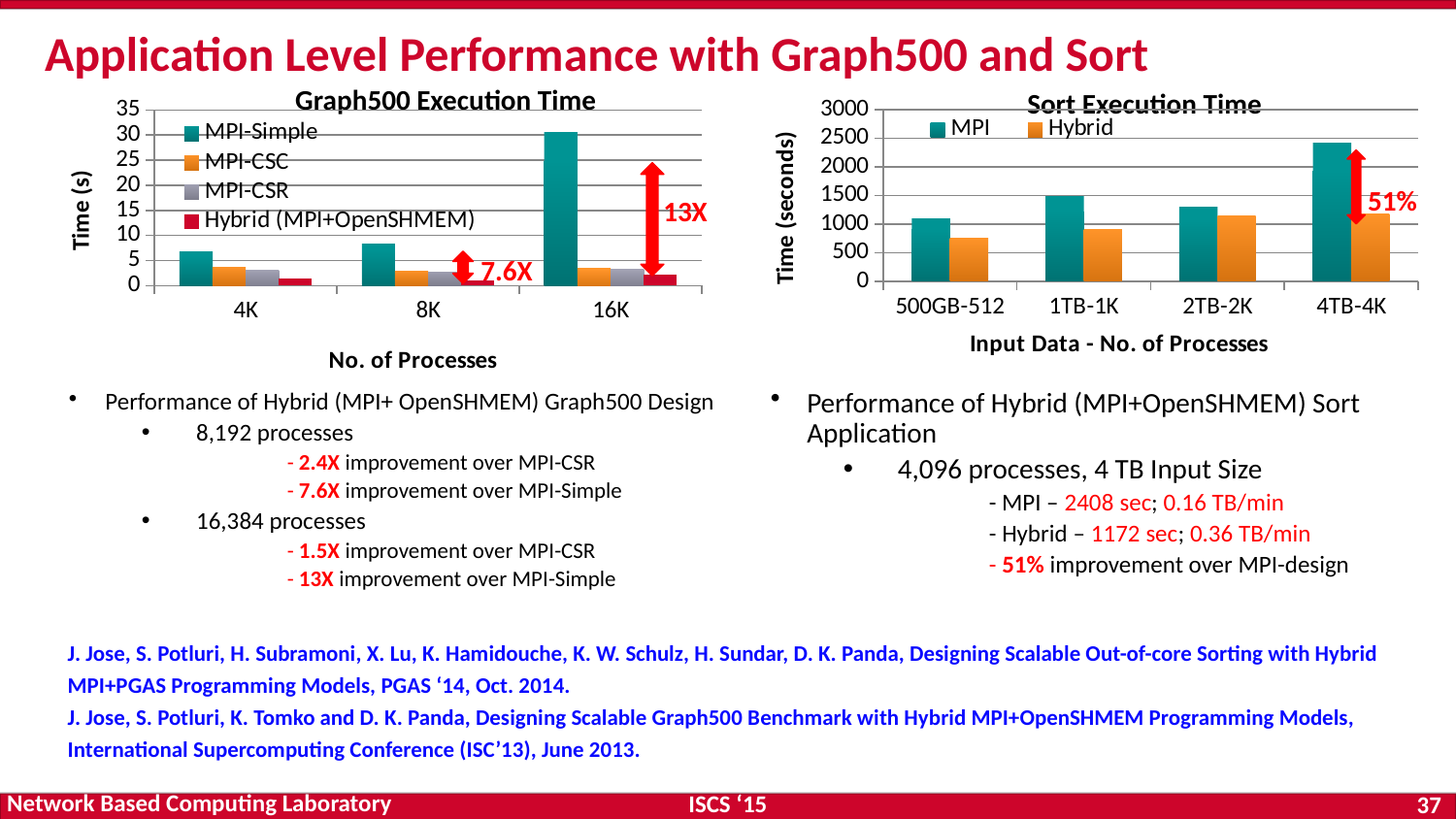
In the Graph500 Execution Time chart, is the MPI-Simple value at 16K greater or less than 25? greater How many categories are shown on the x axis of the Sort Execution Time chart? 4 In the Sort Execution Time chart, which category has the highest MPI bar? 4TB-4K How many series does the legend of the Sort Execution Time chart list? 2 In the Sort Execution Time chart, is the MPI value at 4TB-4K greater or less than 2000? greater How many process-count categories are shown on the x axis of the Graph500 Execution Time chart? 3 In the Sort Execution Time chart, which is larger at 2TB-2K, MPI or Hybrid? MPI What kind of chart is the Graph500 Execution Time chart? bar chart In the Graph500 Execution Time chart, is the Hybrid (MPI+OpenSHMEM) value at 16K greater or less than 5? less In the Sort Execution Time chart, do the Hybrid values rise or fall from 500GB-512 to 4TB-4K? rise How many series does the legend of the Graph500 Execution Time chart list? 4 In the Graph500 Execution Time chart, which series has the tallest bar at 16K processes? MPI-Simple